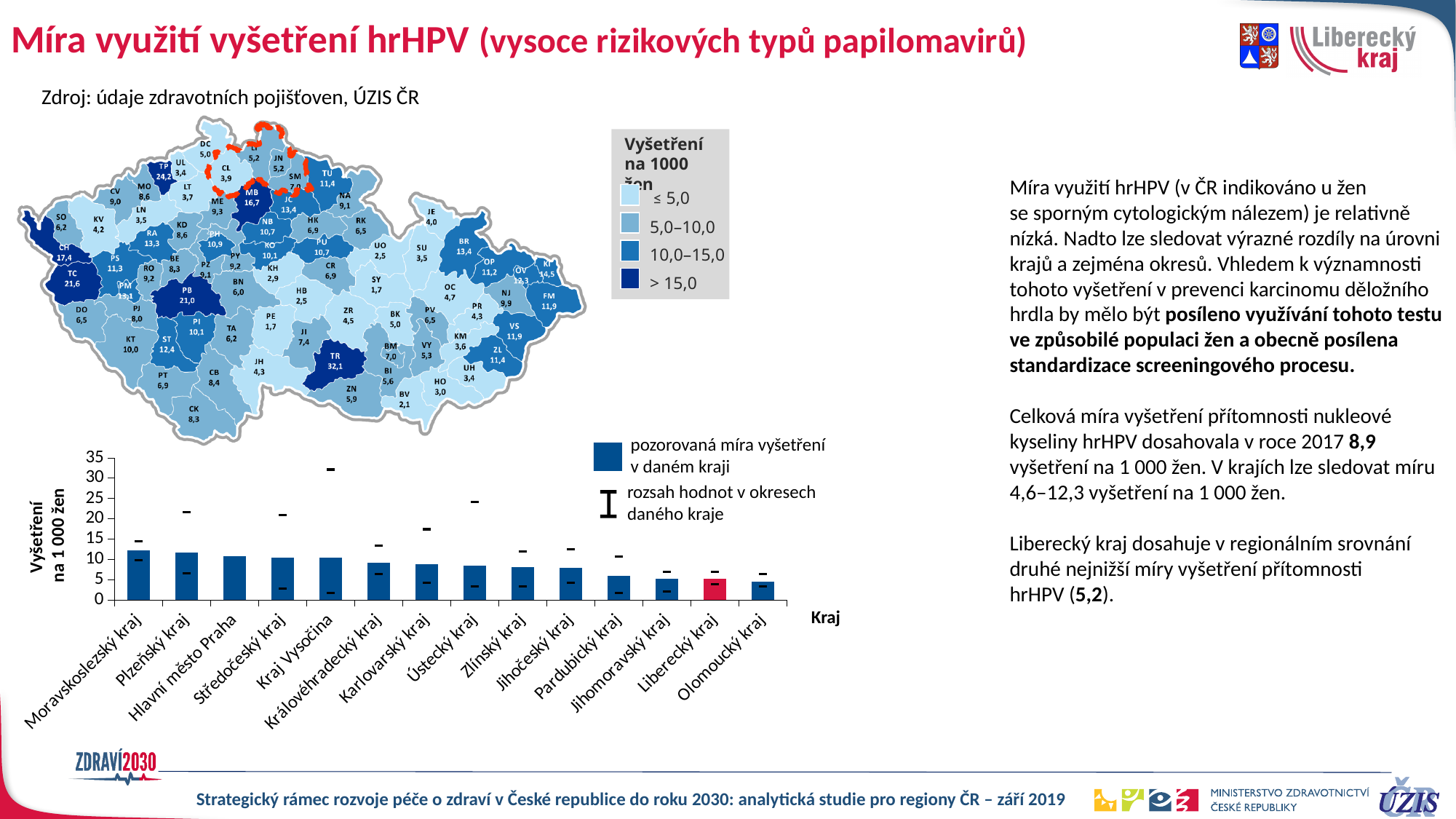
In the bar chart, which region has the highest observed rate of hrHPV testing? Moravskoslezský kraj In the bar chart, do the bar values rise or fall from left to right along the x axis? fall In the bar chart, which region's bar is coloured red instead of blue? Liberecký kraj What kind of chart is shown at the bottom left of the slide, below the map? bar chart On the map, which district has the highest number of hrHPV tests per 1000 women? TR (32,1) On the map, what is the value shown for district CL? 3,9 On the map, what is the difference between the values for districts TR (32,1) and TP (24,2)? 7,9 In the bar chart, is the value for Moravskoslezský kraj greater or less than 10? greater In the bar chart, which region has the lowest observed rate of hrHPV testing? Olomoucký kraj In the bar chart, how many regions (kraje) are shown on the x axis? 14 How many value classes does the map legend 'Vyšetření na 1000 žen' list? 4